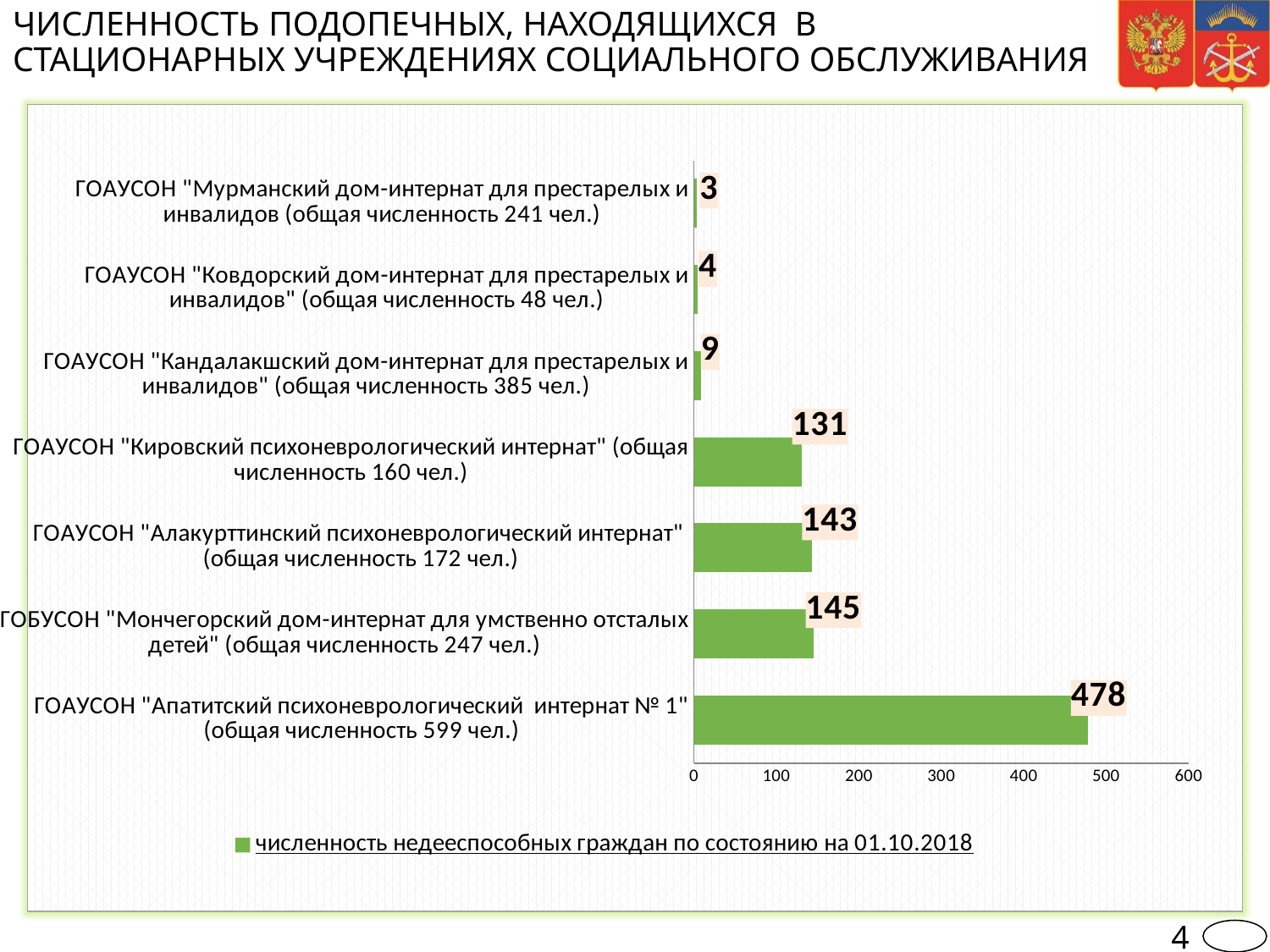
What is the value for ГОАУСОН "Кировский психоневрологический интернат"? 131 Is the value for ГОАУСОН "Кандалакшский дом-интернат для престарелых и инвалидов" greater or less than 100? less What is the value for ГОБУСОН "Мончегорский дом-интернат для умственно отсталых детей"? 145 How many institutions are shown in the chart? 7 What is the value for ГОАУСОН "Мурманский дом-интернат для престарелых и инвалидов"? 3 What is the value for ГОАУСОН "Апатитский психоневрологический интернат № 1"? 478 Which is larger: the value for ГОАУСОН "Алакурттинский психоневрологический интернат" or ГОАУСОН "Кировский психоневрологический интернат"? ГОАУСОН "Алакурттинский психоневрологический интернат" What is the difference between the values for ГОАУСОН "Апатитский психоневрологический интернат № 1" and ГОБУСОН "Мончегорский дом-интернат для умственно отсталых детей"? 333 What kind of chart is shown on the slide? bar chart Which institution has the lowest value? ГОАУСОН "Мурманский дом-интернат для престарелых и инвалидов" What is the legend entry of the series shown in the chart? численность недееспособных граждан по состоянию на 01.10.2018 Which institution has the highest value? ГОАУСОН "Апатитский психоневрологический интернат № 1"